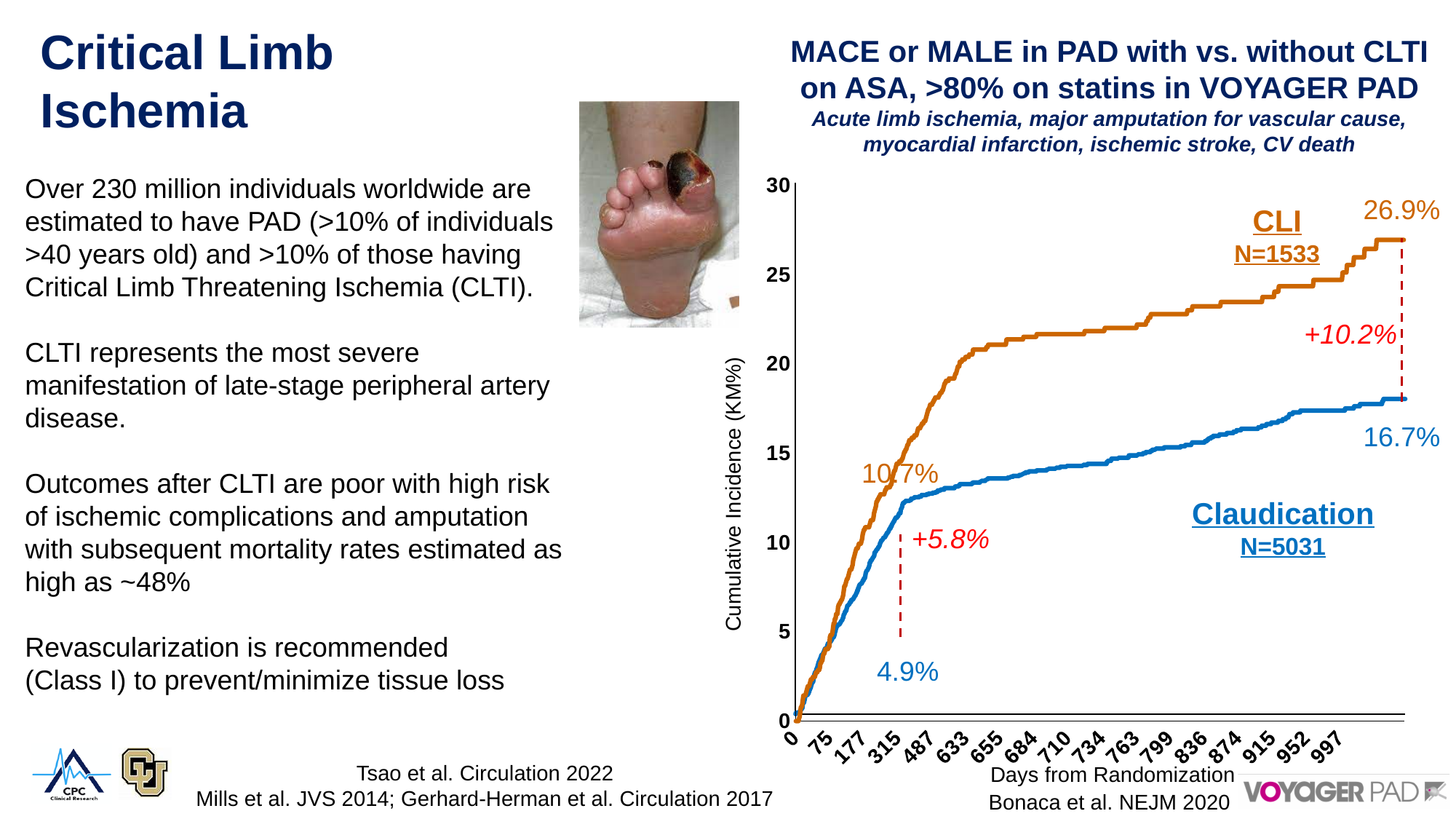
How many series (patient groups) are plotted on the chart? 2 What is the difference between the final cumulative incidence of the CLI group and the Claudication group? 10.2% Do the cumulative incidence curves rise or fall as days from randomization increase? rise What is the sample size (N) of the CLI group? N=1533 What type of chart is shown on the slide? line chart What is the final labeled cumulative incidence for the Claudication group? 16.7% What is the sample size (N) of the Claudication group? N=5031 What is the final labeled cumulative incidence for the CLI group? 26.9% Which group has the higher cumulative incidence at the end of follow-up, CLI or Claudication? CLI What is the labeled early cumulative incidence for the Claudication group at the first dashed line? 4.9% Is the cumulative incidence for the Claudication group at day 633 greater or less than 20? less What is the difference between the early labeled values of the CLI group (10.7%) and the Claudication group (4.9%)? 5.8%